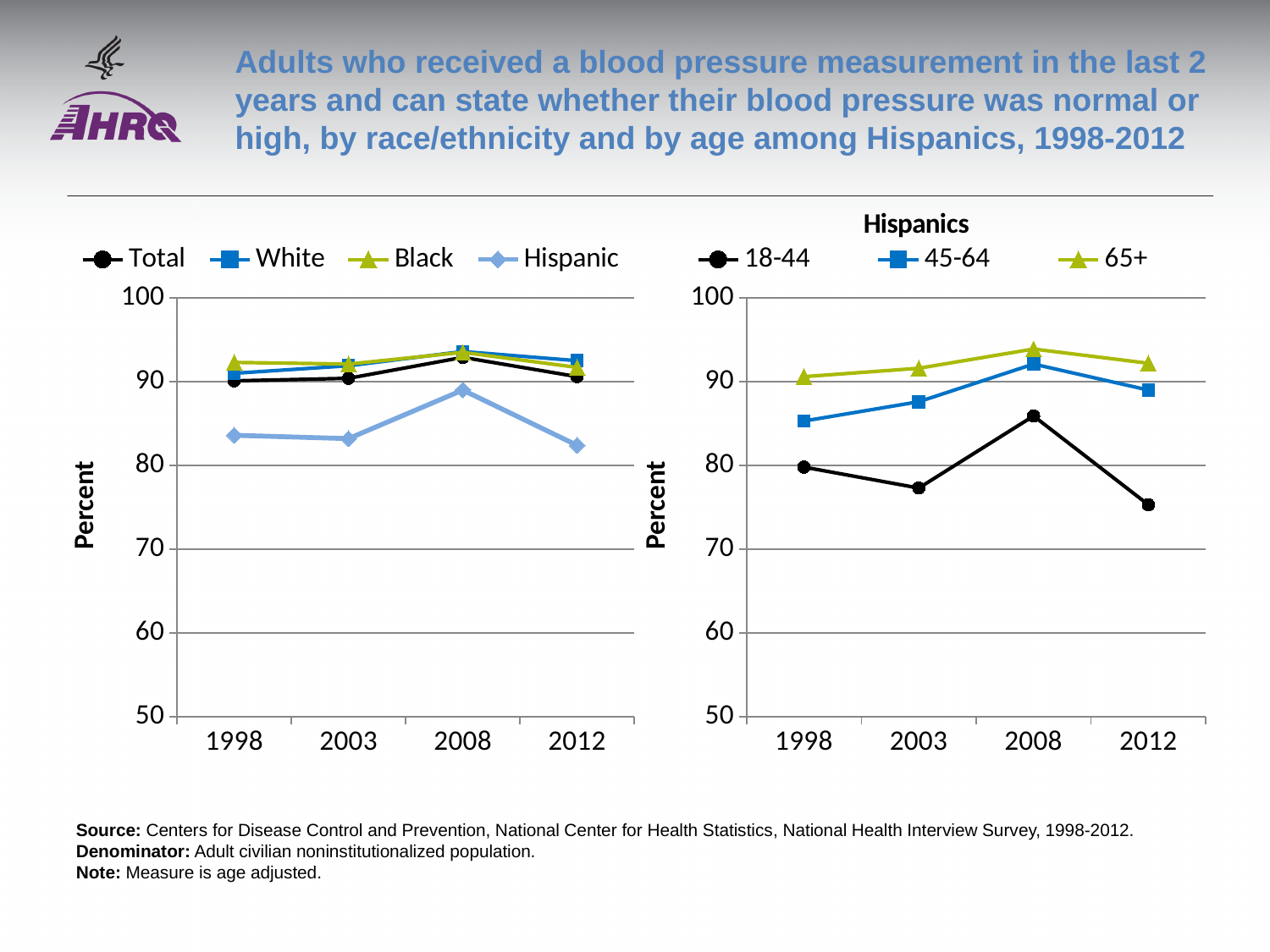
In the left chart, which series has the lowest value in 2012? Hispanic In the right chart (Hispanics), which age group has the highest value in 2008? 65+ How many series does the legend of the left chart list? 4 In the right chart (Hispanics), does the 18-44 line rise or fall from 2008 to 2012? fall In the left chart, is the value for Hispanic in 1998 greater or less than 90? less What is the title shown above the right chart? Hispanics What kind of chart is the left chart on the slide? line chart How many years are shown on the x axis of the right chart (Hispanics)? 4 In the left chart, is the Hispanic value larger in 2008 or in 2012? 2008 How many series does the legend of the right chart (Hispanics) list? 3 In the left chart, is the value for Black in 2008 greater or less than 90? greater In the right chart (Hispanics), is the value for 18-44 in 2012 greater or less than 80? less